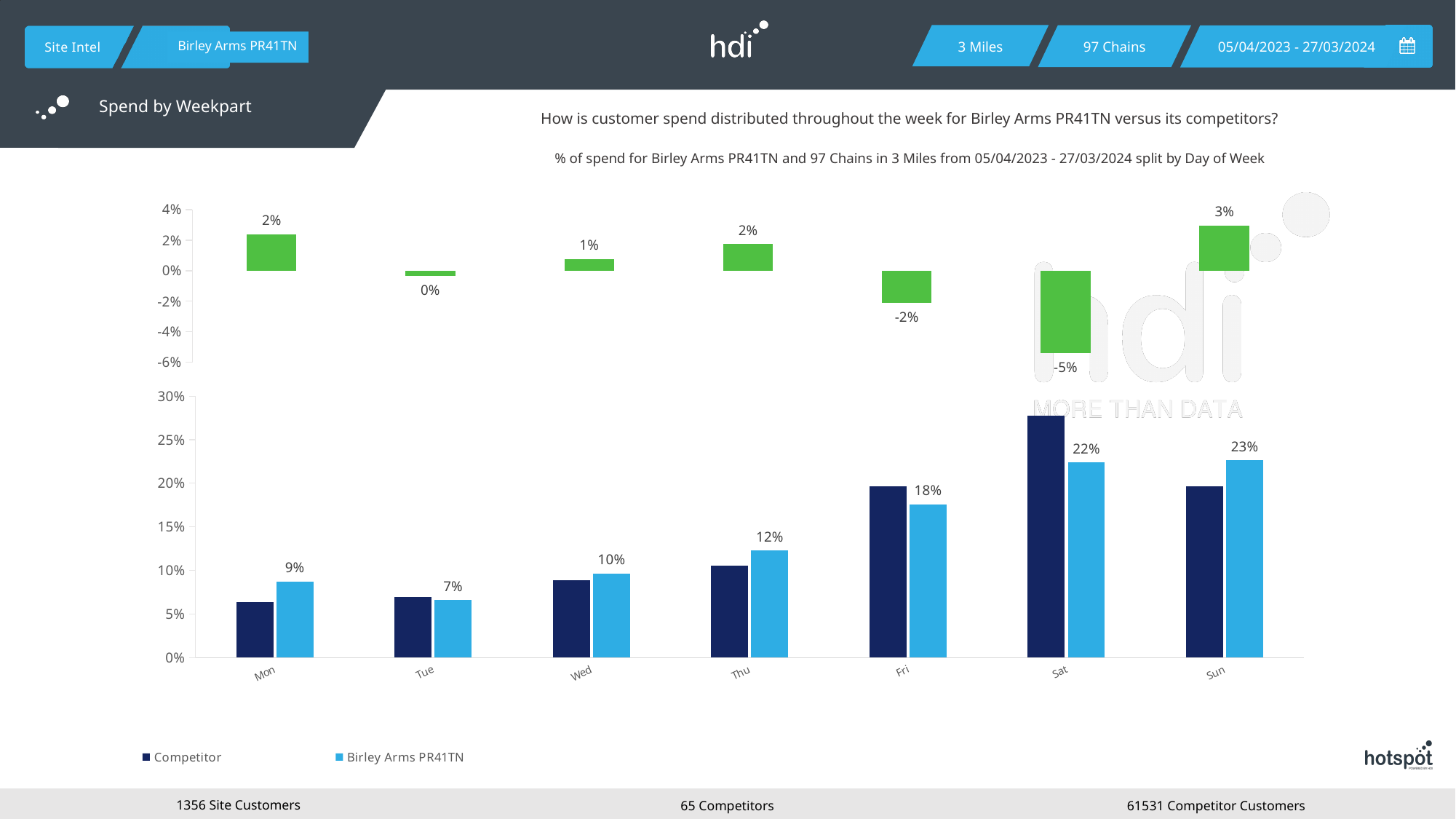
In the top green chart, which day has the highest value? Sun In the bottom chart, what is the value for Birley Arms PR41TN on Sat? 22% In the bottom chart, which is larger on Thu: the Competitor bar or the Birley Arms PR41TN bar? Birley Arms PR41TN How many days are shown on the x axis of the bottom chart? 7 In the bottom chart, which day has the highest Birley Arms PR41TN value? Sun In the bottom chart, which day has the lowest Birley Arms PR41TN value? Tue In the bottom chart, is the Competitor value for Mon greater or less than 10%? less In the bottom chart, what is the difference between the Birley Arms PR41TN values for Sun and Fri? 5% How many series does the legend of the bottom chart list? 2 In the bottom chart, is the Competitor value for Sat greater or less than 25%? greater In the bottom chart, what is the value for Birley Arms PR41TN on Mon? 9% In the top green chart, what is the value for Sat? -5%